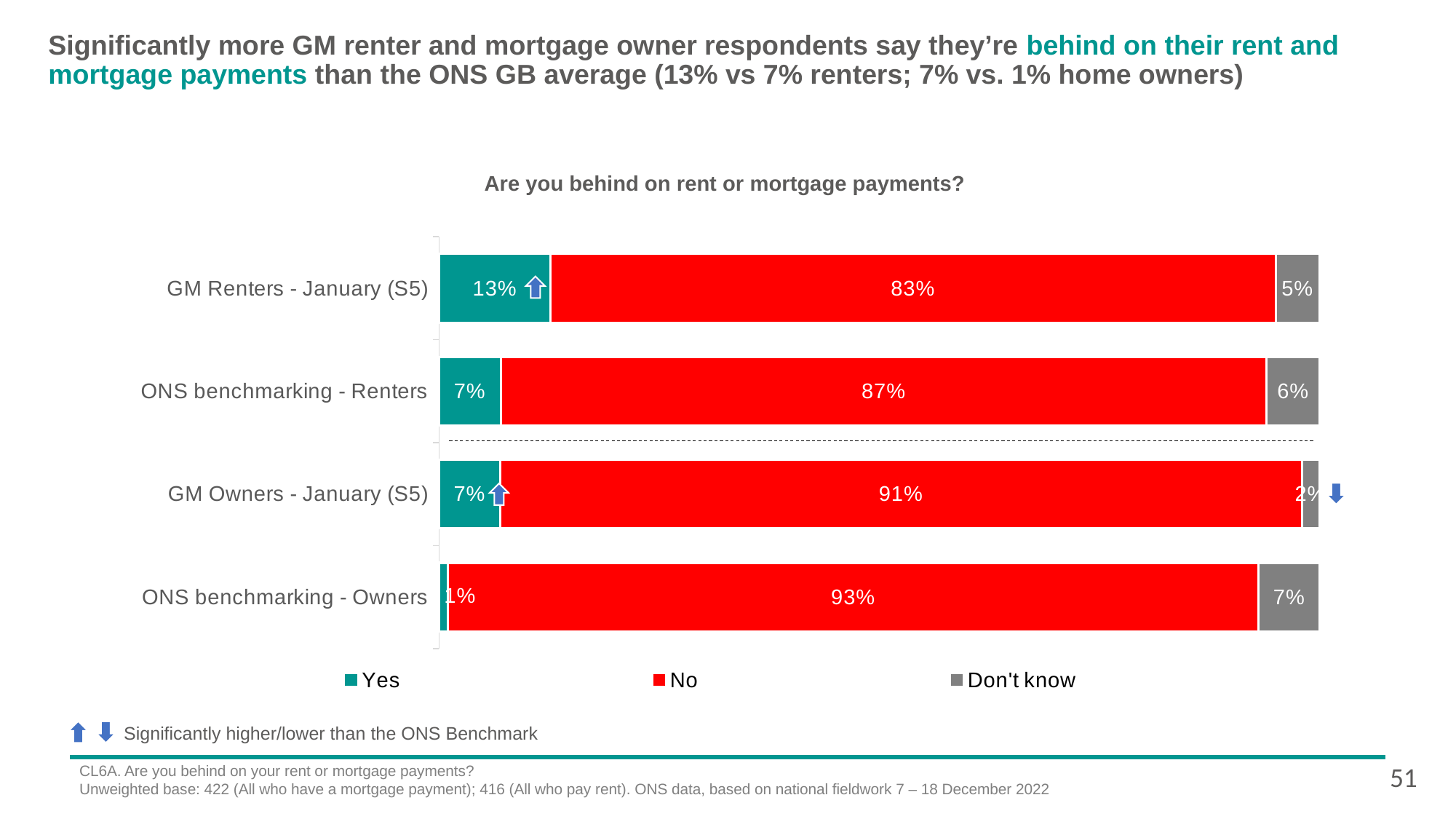
Which category has the highest Yes value? GM Renters - January (S5) What is the difference between the Yes values for GM Renters - January (S5) and ONS benchmarking - Renters? 6% What is the Don't know value for GM Owners - January (S5)? 2% How many categories are shown on the chart? 4 What percentage of GM Renters - January (S5) respondents answered Yes? 13% What is the title of the chart? Are you behind on rent or mortgage payments? How many series does the legend list? 3 Which is larger: the No value for GM Owners - January (S5) or the No value for ONS benchmarking - Renters? GM Owners - January (S5) What is the No value for ONS benchmarking - Owners? 93% What kind of chart is shown on the slide? Stacked bar chart Which category has the lowest Yes value? ONS benchmarking - Owners What is the total of the stacked bar for ONS benchmarking - Renters? 100%